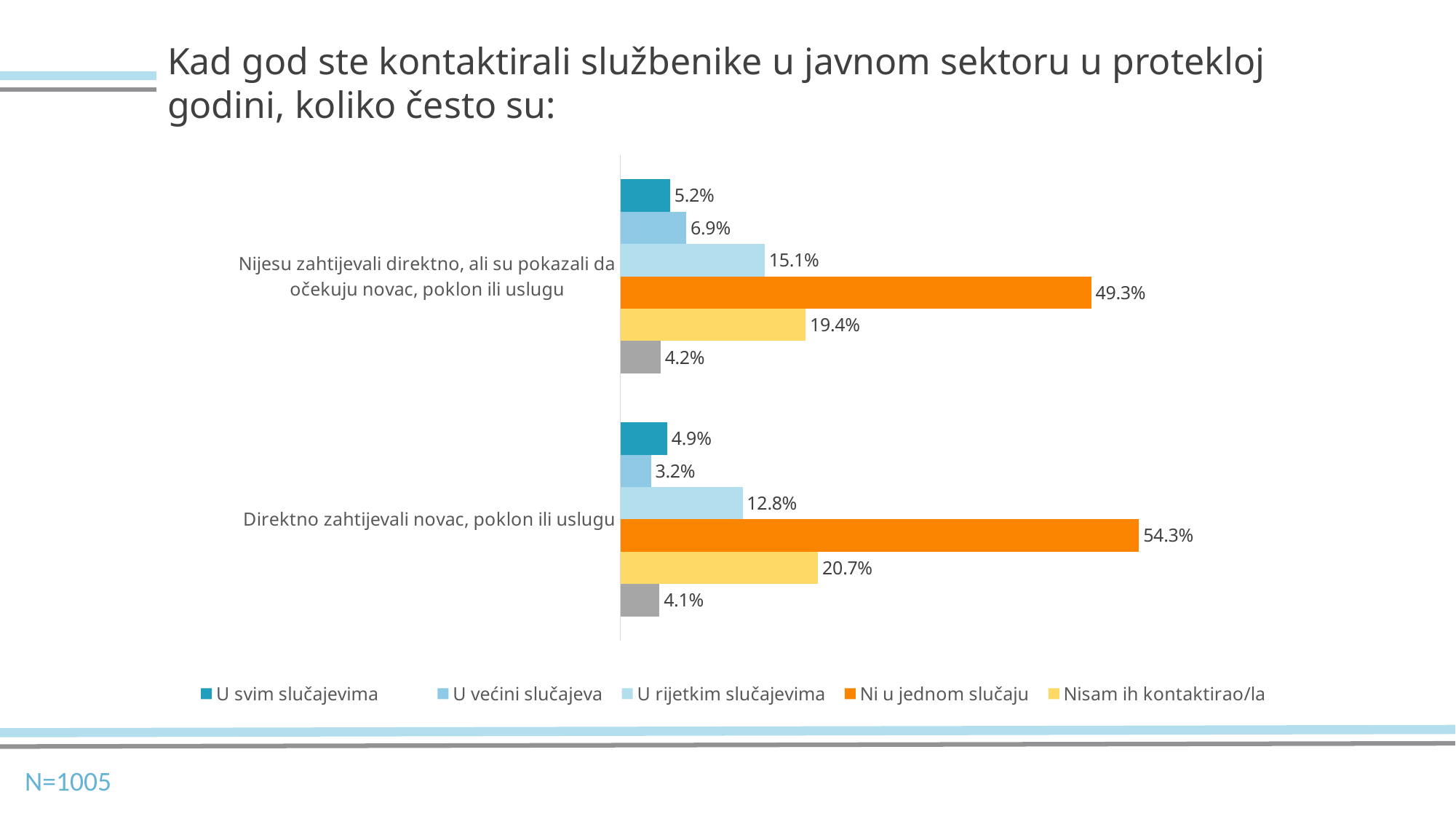
How many categories are shown on the vertical axis? 2 What is the difference between the 'Ni u jednom slučaju' values for the two categories? 5.0% Which is larger: 'U većini slučajeva' for 'Nijesu zahtijevali direktno, ali su pokazali da očekuju novac, poklon ili uslugu' or 'U većini slučajeva' for 'Direktno zahtijevali novac, poklon ili uslugu'? Nijesu zahtijevali direktno, ali su pokazali da očekuju novac, poklon ili uslugu What colour are the bars for the series 'Ni u jednom slučaju'? orange What is the value for 'Ni u jednom slučaju' in the category 'Nijesu zahtijevali direktno, ali su pokazali da očekuju novac, poklon ili uslugu'? 49.3% Which legend series has the lowest value in the category 'Direktno zahtijevali novac, poklon ili uslugu'? U većini slučajeva How many series does the legend list? 5 What is the value for 'Ni u jednom slučaju' in the category 'Direktno zahtijevali novac, poklon ili uslugu'? 54.3% What kind of chart is shown on the slide? bar chart What is the value for 'Nisam ih kontaktirao/la' in the category 'Nijesu zahtijevali direktno, ali su pokazali da očekuju novac, poklon ili uslugu'? 19.4% Which series has the highest value in the category 'Direktno zahtijevali novac, poklon ili uslugu'? Ni u jednom slučaju What is the value for 'U rijetkim slučajevima' in the category 'Direktno zahtijevali novac, poklon ili uslugu'? 12.8%